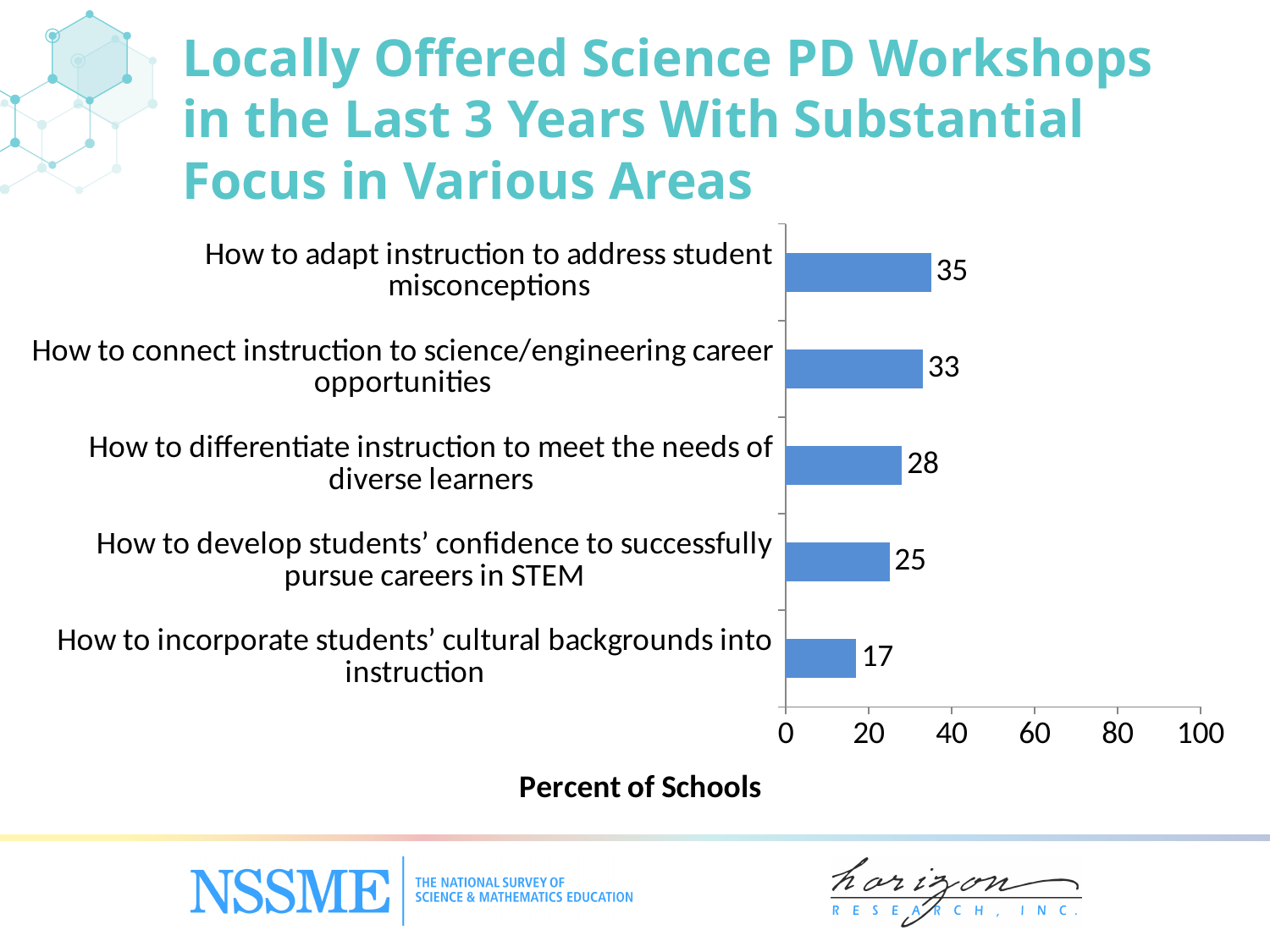
What is the difference in percent of schools between 'How to adapt instruction to address student misconceptions' and 'How to incorporate students' cultural backgrounds into instruction'? 18 What percent of schools had locally offered science PD workshops with substantial focus on how to adapt instruction to address student misconceptions? 35 What kind of chart is shown on the slide? Bar chart What is the difference between the values for 'How to connect instruction to science/engineering career opportunities' and 'How to develop students' confidence to successfully pursue careers in STEM'? 8 Which area has the lowest percent of schools? How to incorporate students' cultural backgrounds into instruction How many areas (categories) are shown in the chart? 5 What is the value for 'How to incorporate students' cultural backgrounds into instruction'? 17 Which area has the highest percent of schools? How to adapt instruction to address student misconceptions What is the value for 'How to differentiate instruction to meet the needs of diverse learners'? 28 Which is larger: the value for 'How to differentiate instruction to meet the needs of diverse learners' or 'How to develop students' confidence to successfully pursue careers in STEM'? How to differentiate instruction to meet the needs of diverse learners What is the label of the horizontal axis? Percent of Schools Is the value for 'How to connect instruction to science/engineering career opportunities' greater or less than 40? less